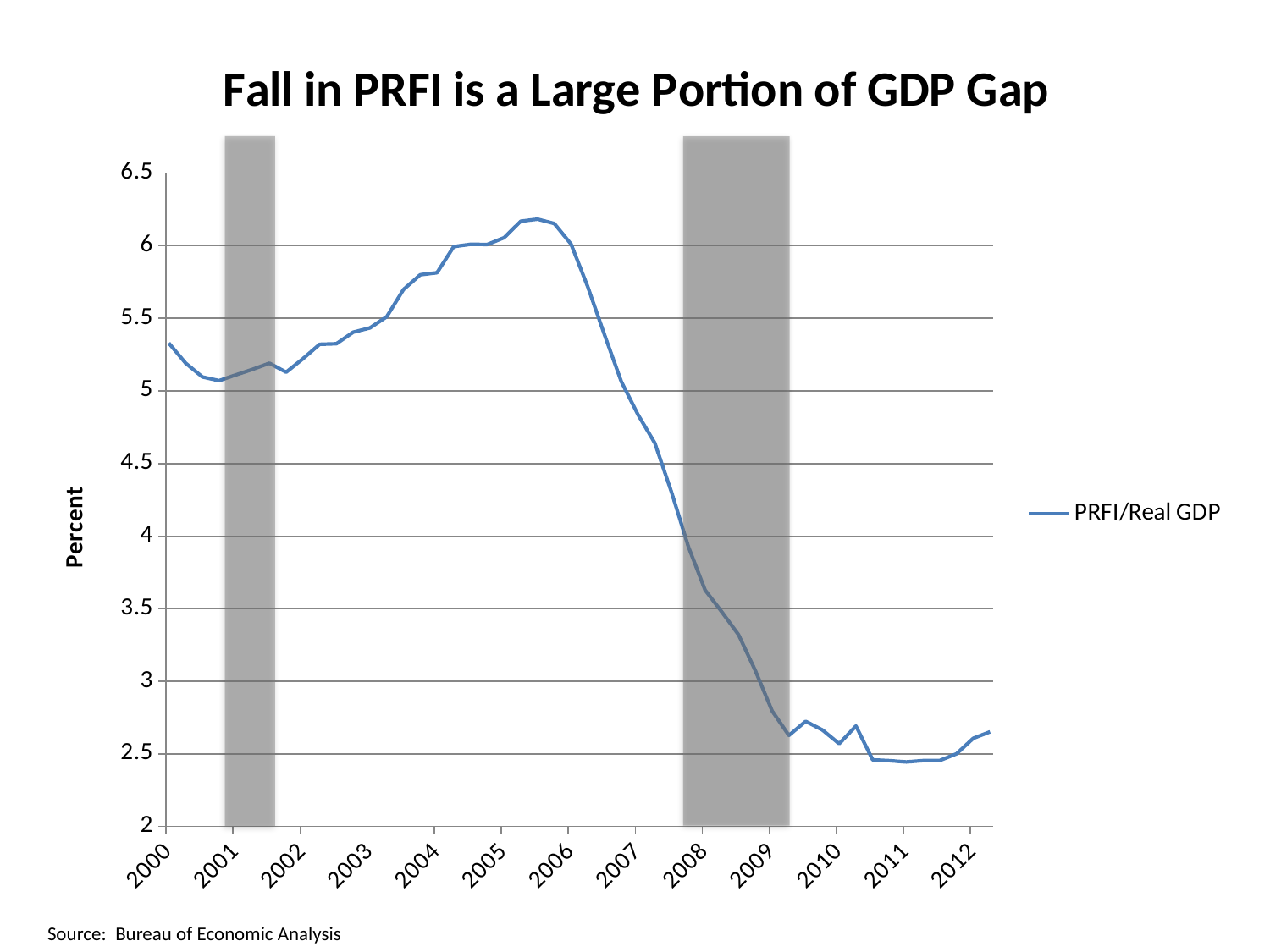
Which year has the larger PRFI/Real GDP value, 2000 or 2012? 2000 How many year labels are shown along the x axis? 13 Is the value for PRFI/Real GDP in 2000 greater or less than 5? greater What is the name of the series shown in the legend? PRFI/Real GDP Is the value for PRFI/Real GDP in 2012 greater or less than 3? less Does the PRFI/Real GDP line rise or fall between 2006 and 2009? fall Is the value for PRFI/Real GDP in 2004 greater or less than 5.5? greater How many series does the legend list? 1 What is the label on the vertical axis? Percent What kind of chart is shown on the slide? line chart Which year has the larger PRFI/Real GDP value, 2004 or 2008? 2004